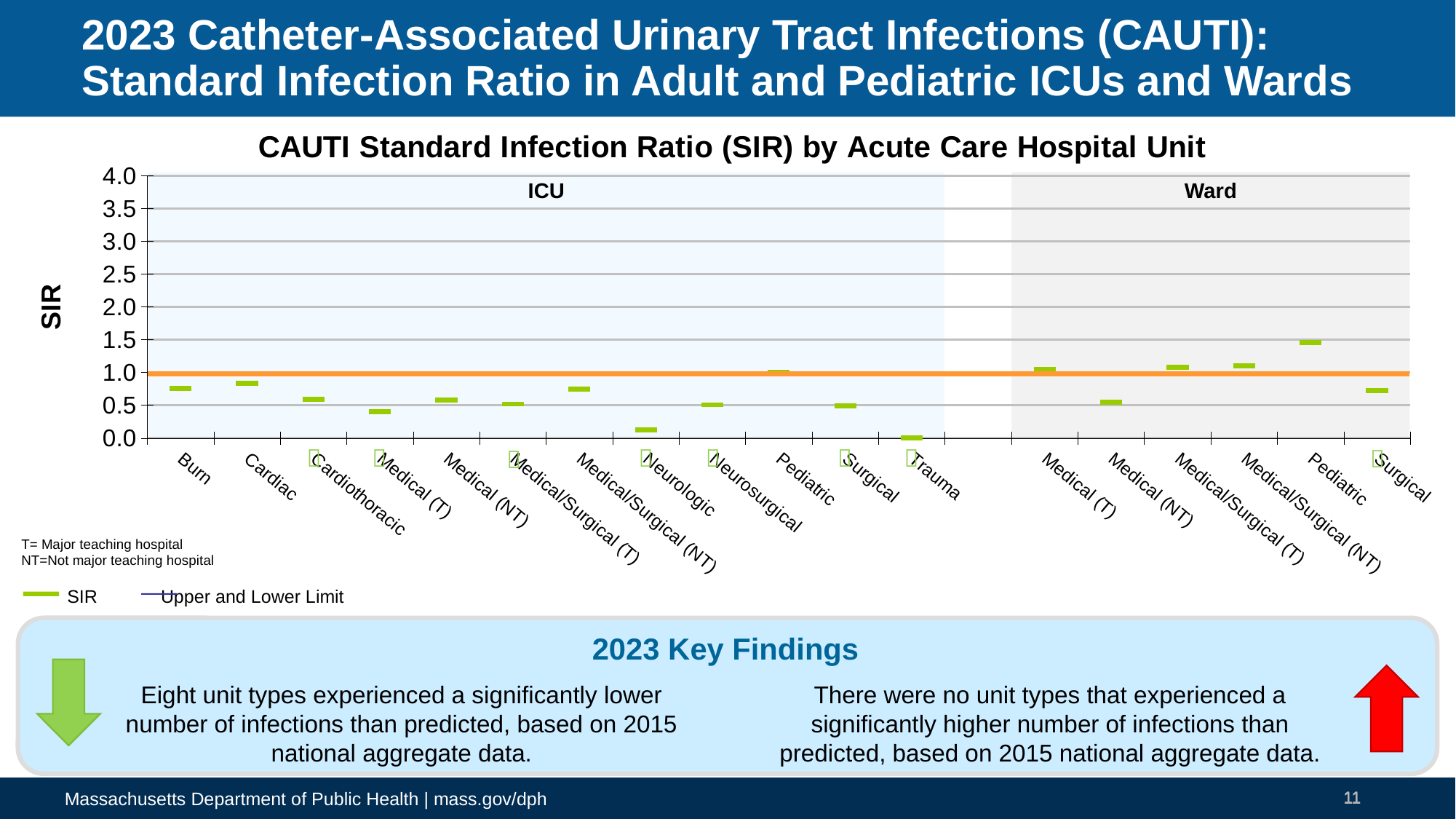
Is the SIR for the Medical/Surgical (NT) Ward greater or less than 1.0? greater How many Ward unit types are plotted on the chart? 6 Is the SIR for the Burn ICU greater or less than 1.0? less Is the SIR for the Pediatric Ward greater or less than 1.0? greater How many ICU unit types are plotted on the chart? 12 Which unit has the highest SIR on the chart? Pediatric (Ward) Which has the larger SIR: the Pediatric ICU or the Pediatric Ward? Pediatric Ward How many entries does the chart legend list? 2 Which unit has the lowest SIR on the chart? Trauma (ICU) What is the title of the chart? CAUTI Standard Infection Ratio (SIR) by Acute Care Hospital Unit Which has the larger SIR: the Burn ICU or the Neurologic ICU? Burn ICU